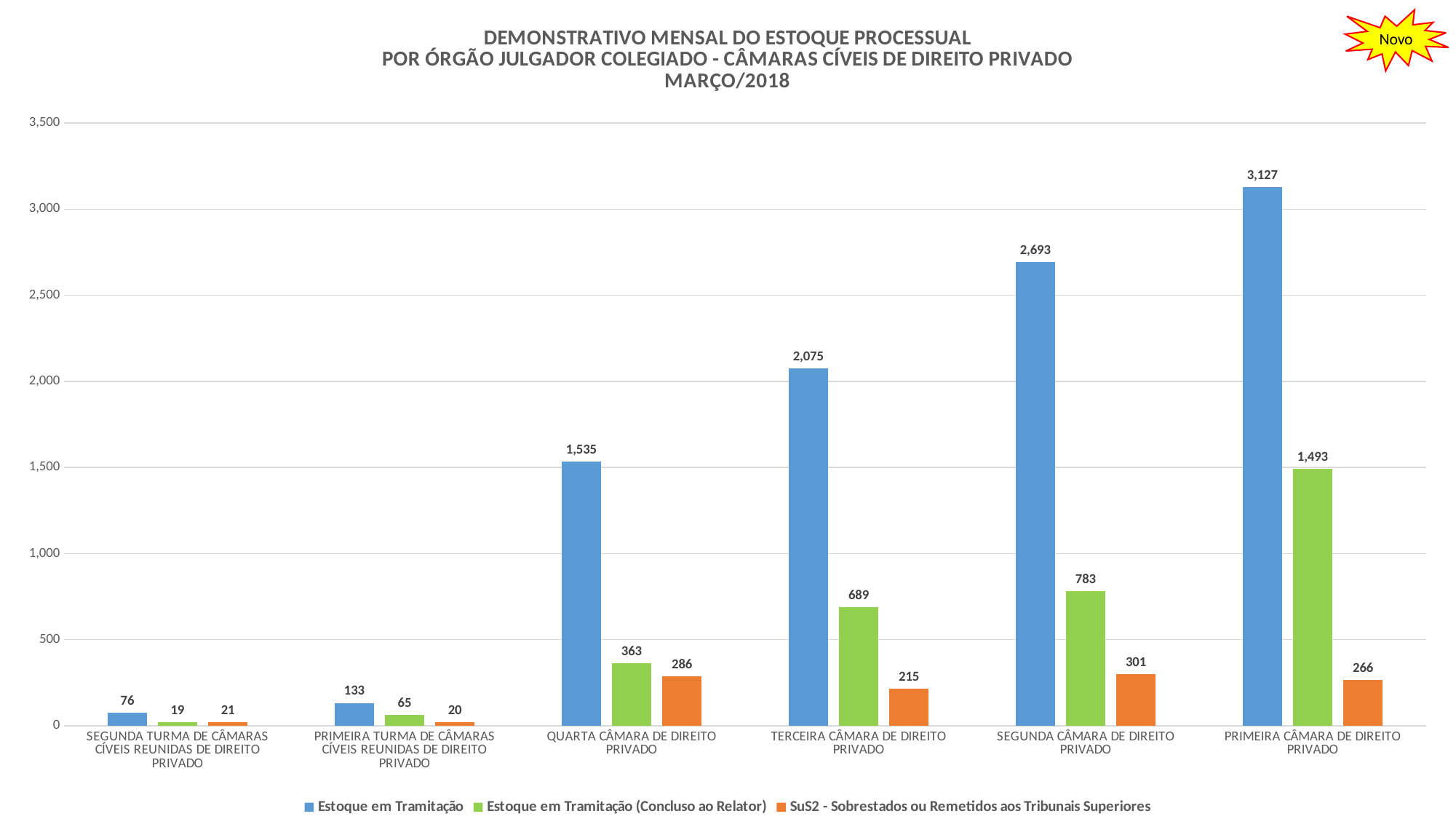
What is the value of Estoque em Tramitação for PRIMEIRA CÂMARA DE DIREITO PRIVADO? 3,127 How many series does the legend list? 3 What is the value of Estoque em Tramitação (Concluso ao Relator) for TERCEIRA CÂMARA DE DIREITO PRIVADO? 689 Which category has the highest value for Estoque em Tramitação? PRIMEIRA CÂMARA DE DIREITO PRIVADO What kind of chart is shown on the slide? bar chart Is the Estoque em Tramitação value for TERCEIRA CÂMARA DE DIREITO PRIVADO greater or less than 2,000? greater How many categories are shown on the x axis? 6 Which is larger: the SuS2 value for SEGUNDA CÂMARA DE DIREITO PRIVADO or for PRIMEIRA CÂMARA DE DIREITO PRIVADO? SEGUNDA CÂMARA DE DIREITO PRIVADO Which category has the lowest value for Estoque em Tramitação (Concluso ao Relator)? SEGUNDA TURMA DE CÂMARAS CÍVEIS REUNIDAS DE DIREITO PRIVADO Which colour represents the series Estoque em Tramitação (Concluso ao Relator)? green What is the value of SuS2 - Sobrestados ou Remetidos aos Tribunais Superiores for QUARTA CÂMARA DE DIREITO PRIVADO? 286 What is the difference between the Estoque em Tramitação values for PRIMEIRA CÂMARA DE DIREITO PRIVADO and SEGUNDA CÂMARA DE DIREITO PRIVADO? 434